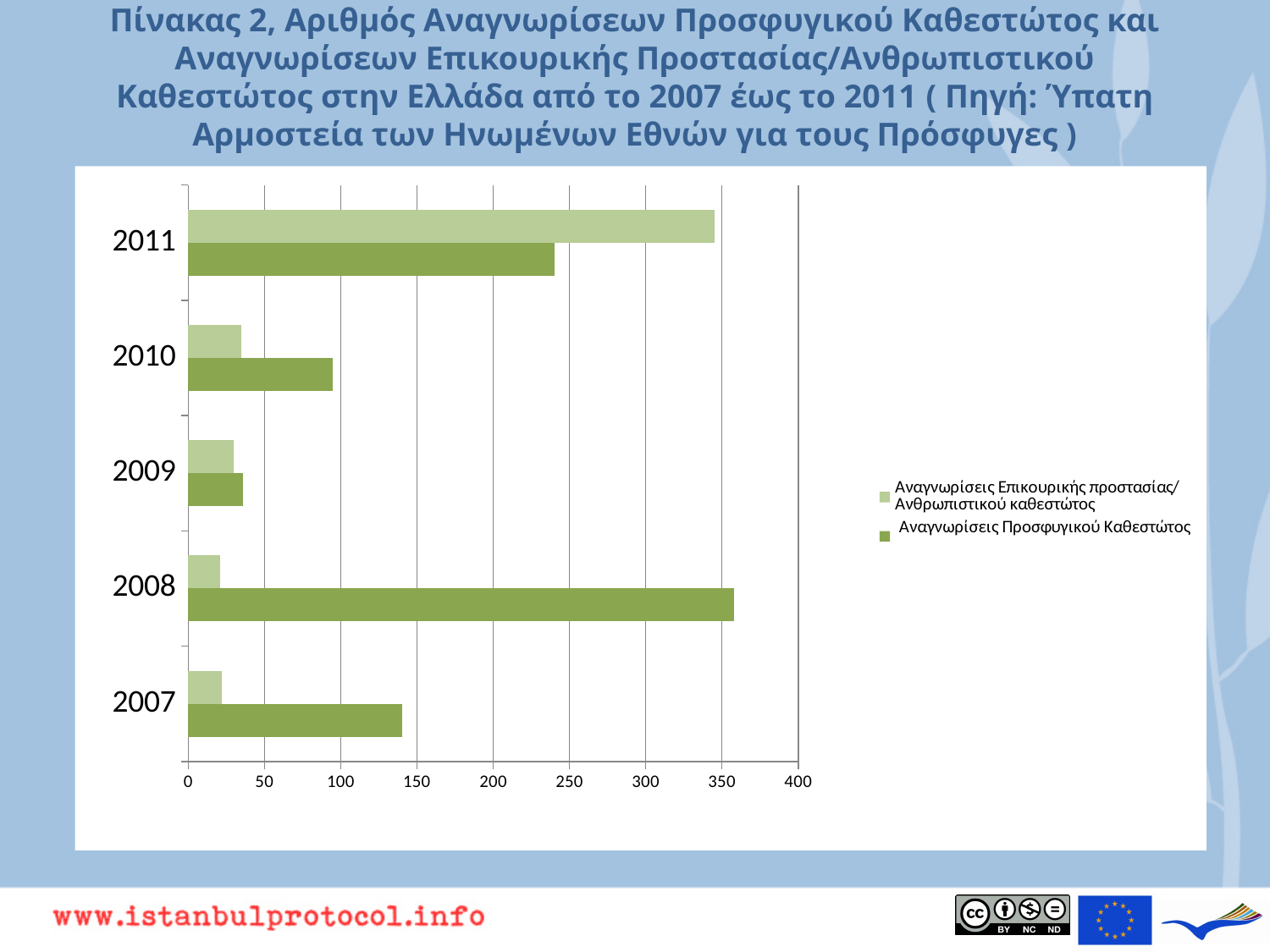
In 2011, which series has the larger value: Αναγνωρίσεις Επικουρικής προστασίας/Ανθρωπιστικού καθεστώτος or Αναγνωρίσεις Προσφυγικού Καθεστώτος? Αναγνωρίσεις Επικουρικής προστασίας/Ανθρωπιστικού καθεστώτος Which year has the lowest value for Αναγνωρίσεις Προσφυγικού Καθεστώτος? 2009 Which year has the highest value for Αναγνωρίσεις Προσφυγικού Καθεστώτος? 2008 Is the value for Αναγνωρίσεις Προσφυγικού Καθεστώτος in 2009 greater or less than 50? less What kind of chart is shown on the slide? bar chart In 2008, which series has the larger value: Αναγνωρίσεις Επικουρικής προστασίας/Ανθρωπιστικού καθεστώτος or Αναγνωρίσεις Προσφυγικού Καθεστώτος? Αναγνωρίσεις Προσφυγικού Καθεστώτος How many series does the legend list? 2 Is the value for Αναγνωρίσεις Προσφυγικού Καθεστώτος in 2007 greater or less than 100? greater Is the value for Αναγνωρίσεις Επικουρικής προστασίας/Ανθρωπιστικού καθεστώτος in 2011 greater or less than 300? greater How many years are shown on the chart? 5 Which year has the highest value for Αναγνωρίσεις Επικουρικής προστασίας/Ανθρωπιστικού καθεστώτος? 2011